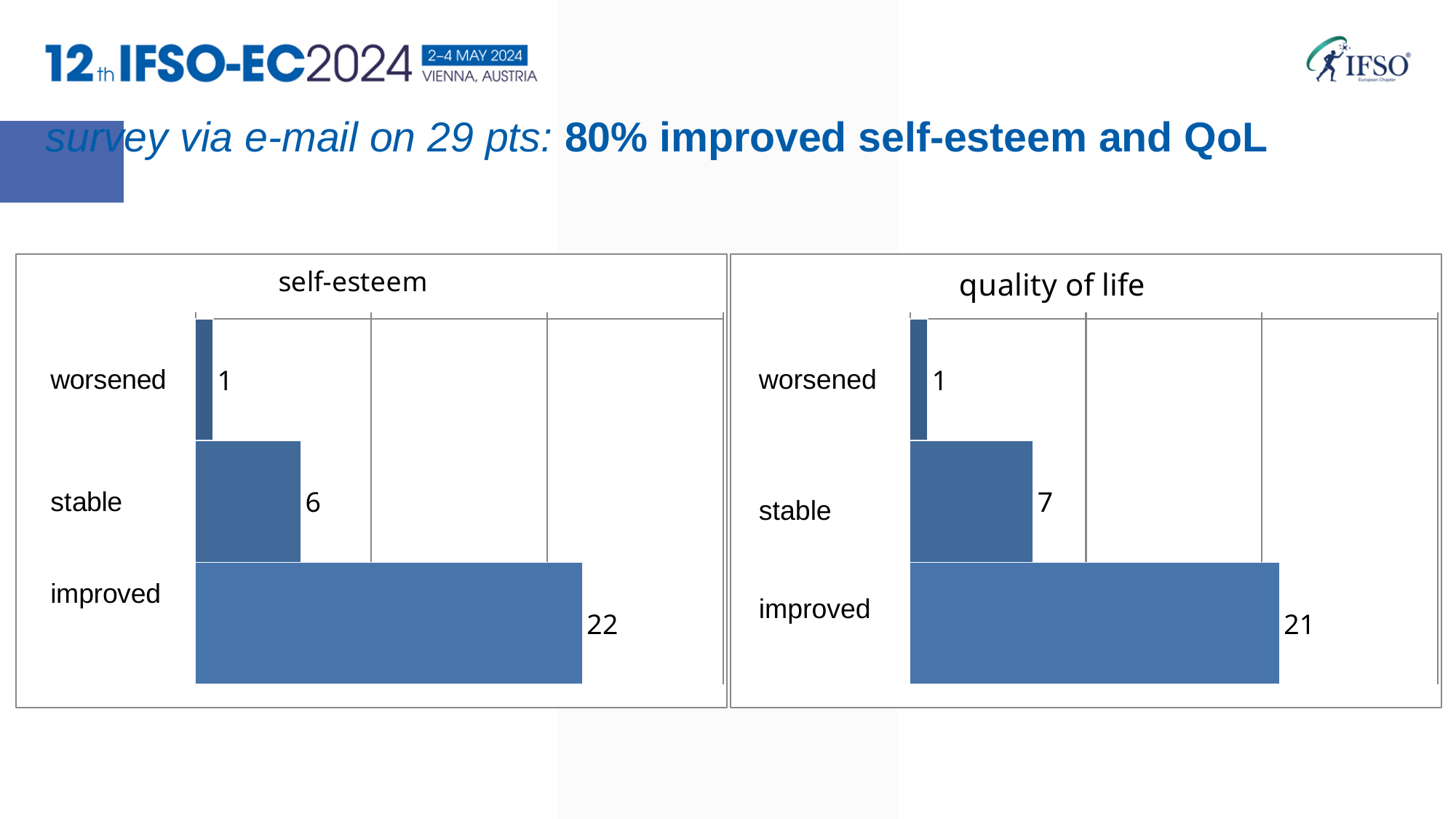
In the 'quality of life' chart, what is the value for 'stable'? 7 In the 'quality of life' chart, what is the difference between the values for 'stable' and 'worsened'? 6 What kind of chart is the 'self-esteem' chart? bar chart In the 'quality of life' chart, what is the value for 'improved'? 21 What is the title of the chart on the right side of the slide? quality of life In the 'self-esteem' chart, which category has the highest value? improved In the 'quality of life' chart, which category has the lowest value? worsened How many categories are shown in the 'quality of life' chart? 3 In the 'self-esteem' chart, what is the value for 'stable'? 6 Which is larger: the 'improved' value in the 'self-esteem' chart or the 'improved' value in the 'quality of life' chart? self-esteem In the 'self-esteem' chart, what is the value for 'improved'? 22 In the 'self-esteem' chart, what is the difference between the values for 'improved' and 'stable'? 16